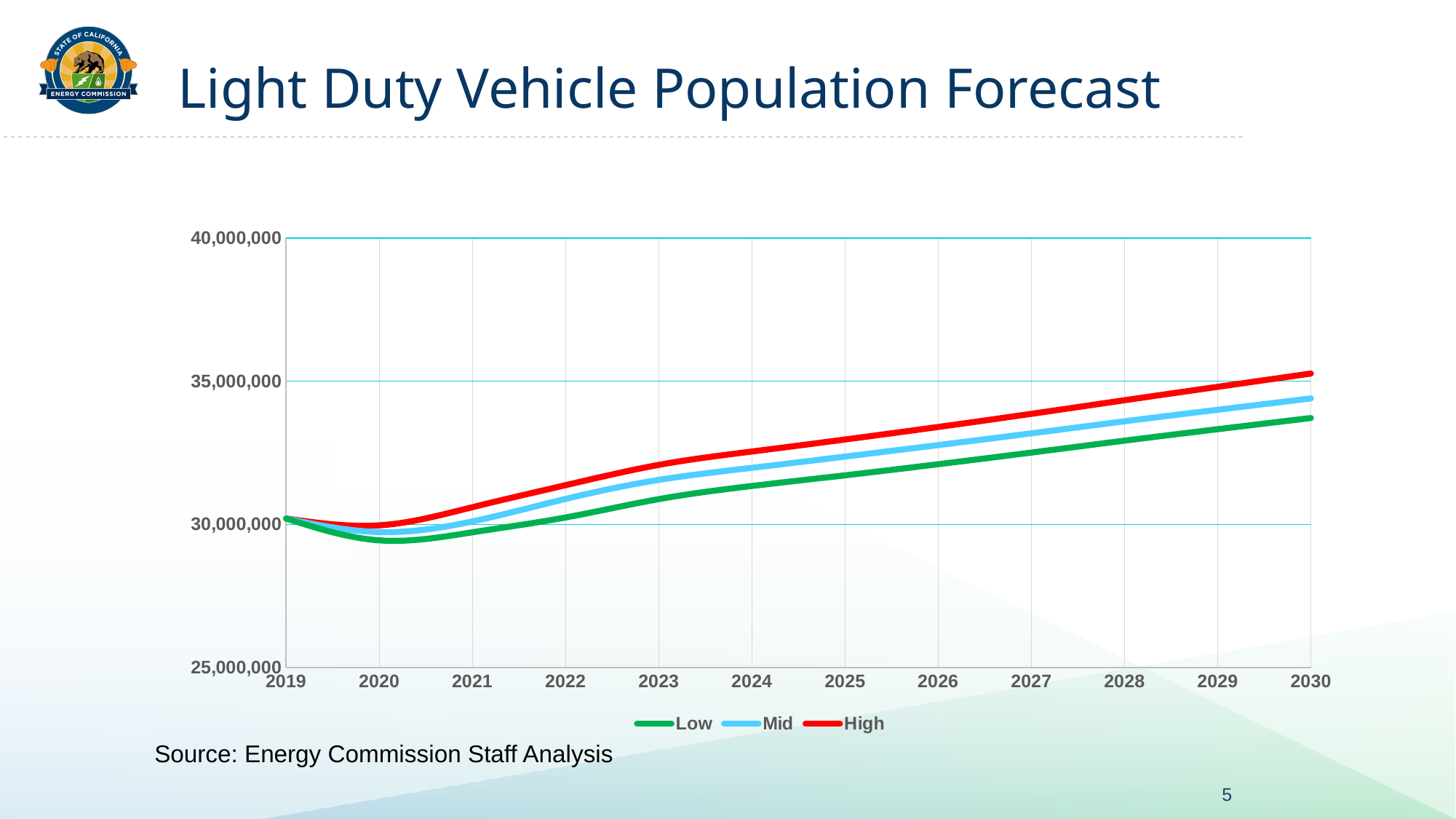
Is the value for the Mid series in 2030 greater or less than 35,000,000? less Is the value for the High series in 2030 greater or less than 35,000,000? greater What kind of chart is shown on the slide? line chart In 2030, which is larger: the High series or the Low series? High Which series has the highest value in 2030? High What is the title of the chart? Light Duty Vehicle Population Forecast Do the values of the High series rise or fall between 2021 and 2030? rise Which series has the lowest value in 2030? Low How many years are shown along the x axis? 12 Is the value for the Mid series in 2025 greater or less than 30,000,000? greater How many series does the legend list? 3